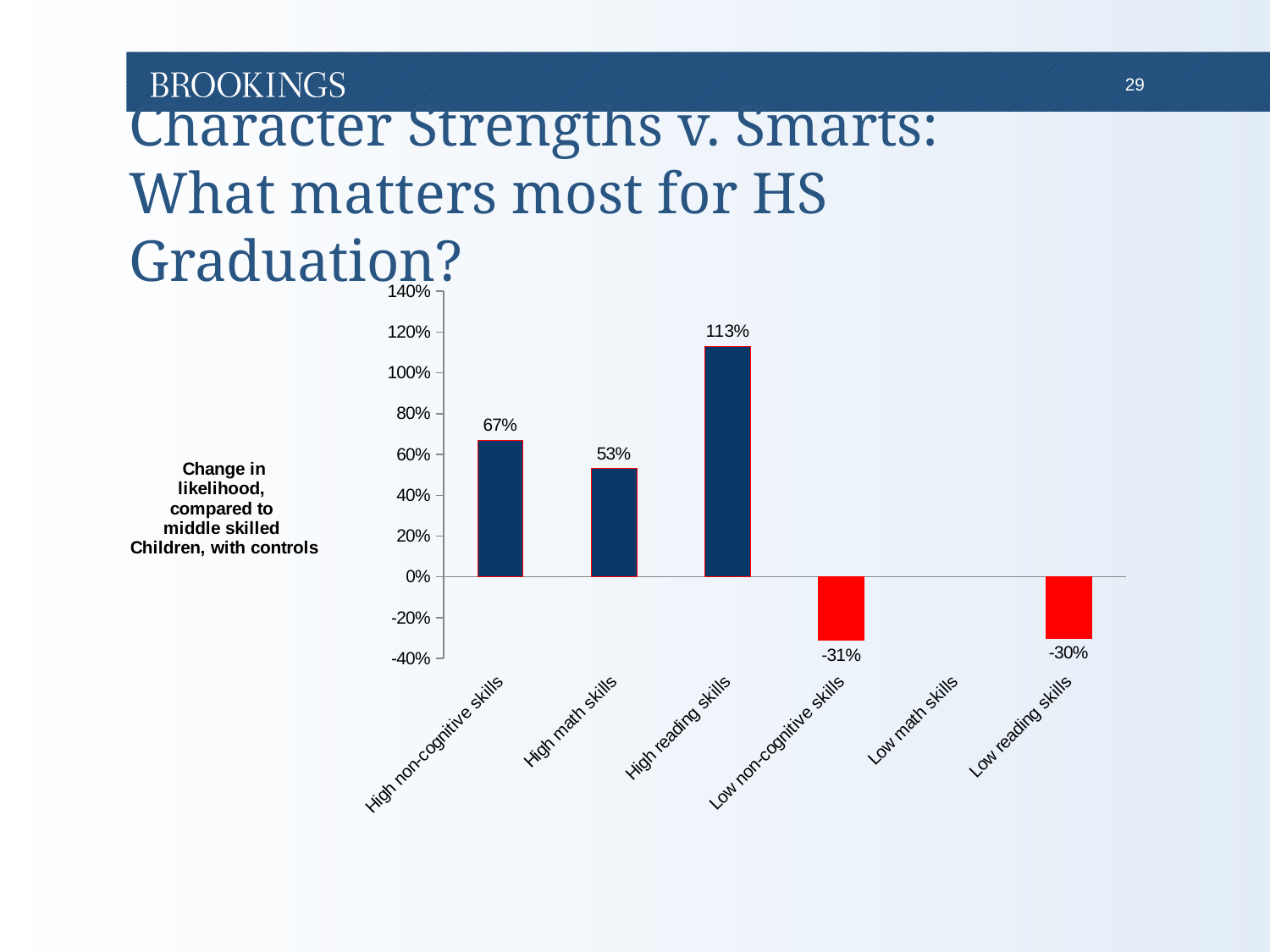
What colour are the bars with negative values? Red What is the difference between the values for High reading skills and High non-cognitive skills? 46% What is the value for High reading skills? 113% How many categories are shown on the x axis? 6 What is the value for High non-cognitive skills? 67% What is the value for Low non-cognitive skills? -31% Which category has the highest value? High reading skills Which category has the lowest value? Low non-cognitive skills What kind of chart is shown on the slide? Bar chart What is the value for Low reading skills? -30% What is the value for High math skills? 53% Which is larger, the value for High non-cognitive skills or the value for High math skills? High non-cognitive skills